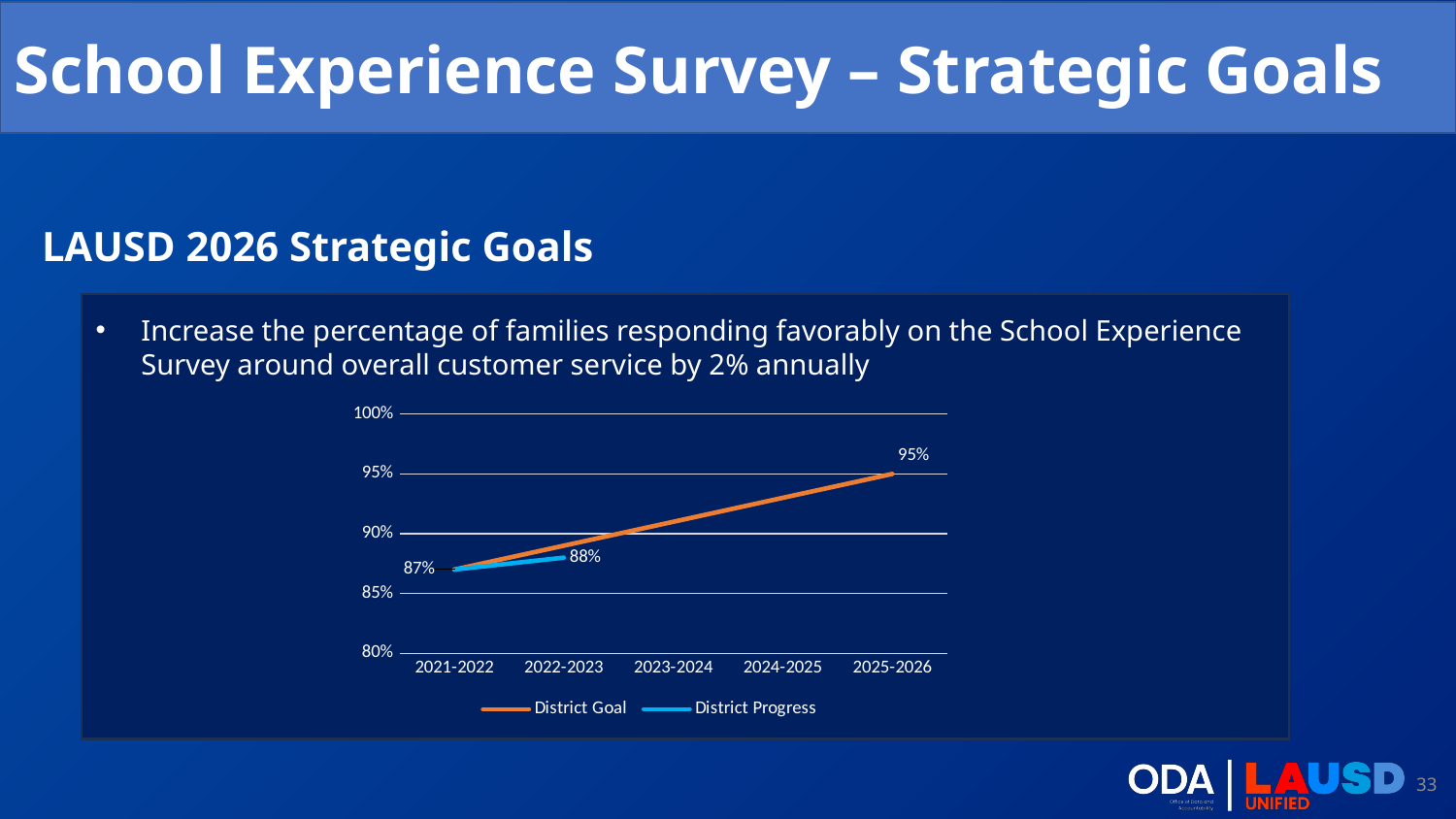
What is the District Progress value for 2022-2023? 88% Does the District Goal line rise or fall from 2021-2022 to 2025-2026? Rise What type of chart is shown on the slide? Line chart What is the difference between the District Progress value for 2022-2023 and the value for 2021-2022? 1% Is the District Goal value for 2023-2024 greater or less than 90%? greater What value is labeled for 2021-2022 on the chart? 87% Which colour is used for the District Goal line in the chart? Orange How many school years are shown on the x axis of the chart? 5 What is the difference between the District Goal value for 2025-2026 and the value for 2021-2022? 8% What is the District Goal value for 2025-2026? 95% What are the two series named in the chart legend? District Goal and District Progress How many series does the chart legend list? 2